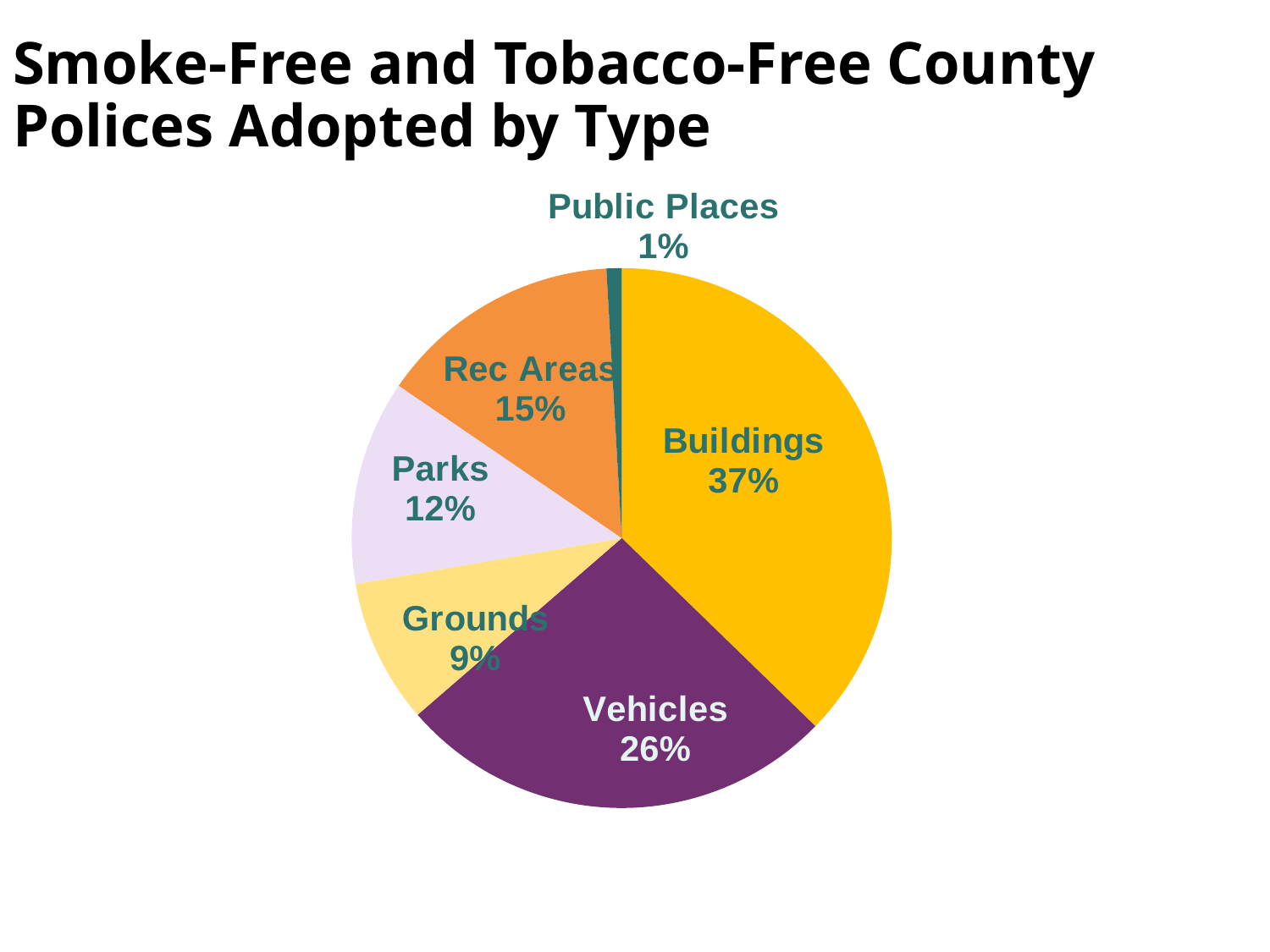
What percentage is shown for Vehicles? 26% What percentage is shown for Parks? 12% What is the title of the chart on the slide? Smoke-Free and Tobacco-Free County Polices Adopted by Type What kind of chart is shown on the slide? pie chart Which is larger, the share for Parks or the share for Grounds? Parks What is the difference in percentage points between Buildings and Vehicles? 11 How many slices does the pie chart have? 6 Which policy type has the largest share of the pie? Buildings What share of the pie does Buildings represent? 37% What percentage is shown for Rec Areas? 15% What percentage is shown for Public Places? 1% Which policy type has the smallest share of the pie? Public Places